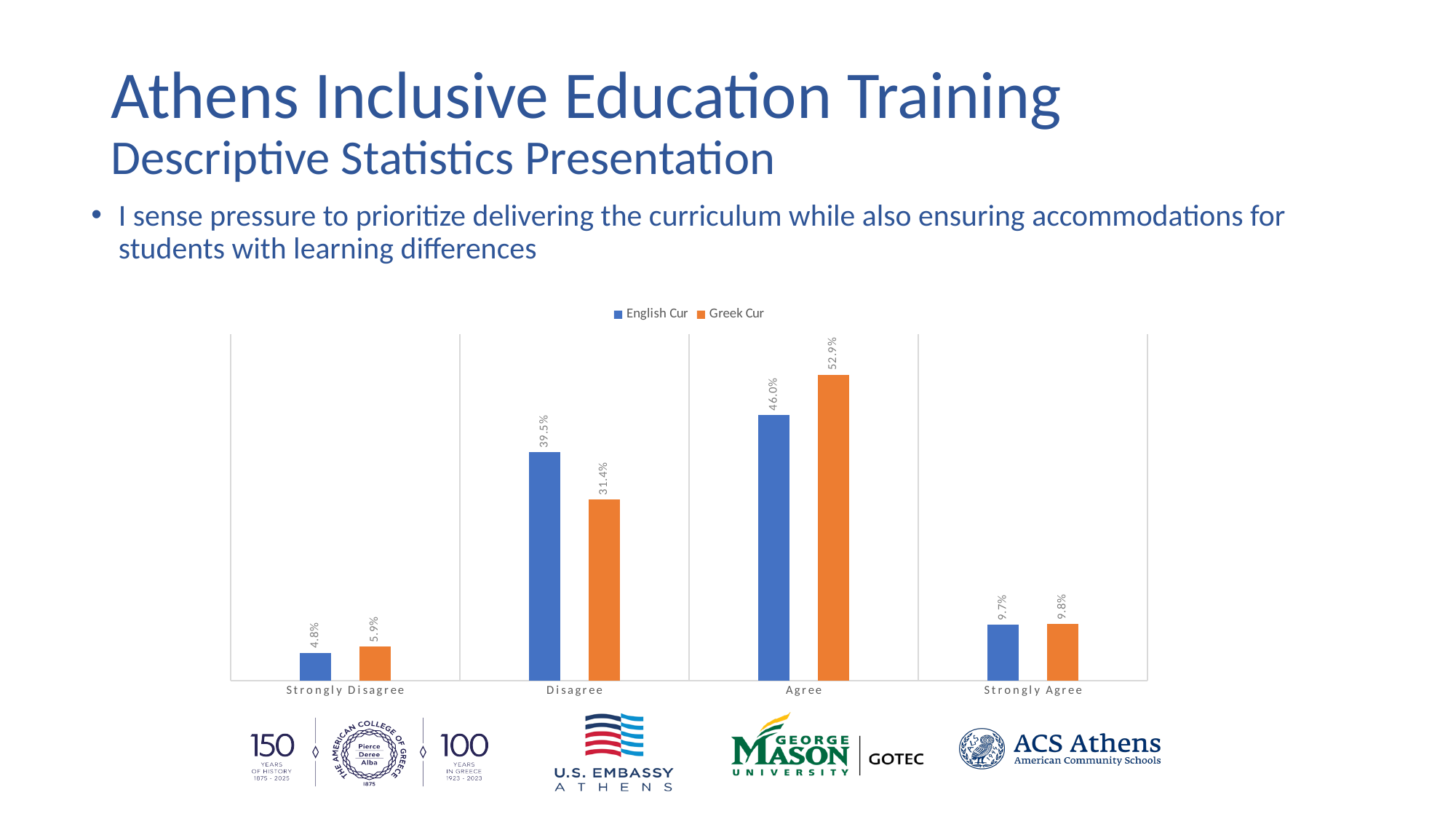
What is the value for English Cur in the Agree category? 46.0% What kind of chart is shown on the slide? Bar chart Which category has the highest value for Greek Cur? Agree What is the difference between the English Cur and Greek Cur values in the Disagree category? 8.1% How many categories are shown on the x axis? 4 In the Disagree category, which series has the larger value, English Cur or Greek Cur? English Cur What is the value for English Cur in the Strongly Agree category? 9.7% What is the difference between the Greek Cur and English Cur values in the Agree category? 6.9% What is the value for Greek Cur in the Strongly Disagree category? 5.9% What is the value for Greek Cur in the Disagree category? 31.4% Which category has the lowest value for English Cur? Strongly Disagree How many series does the legend list? 2